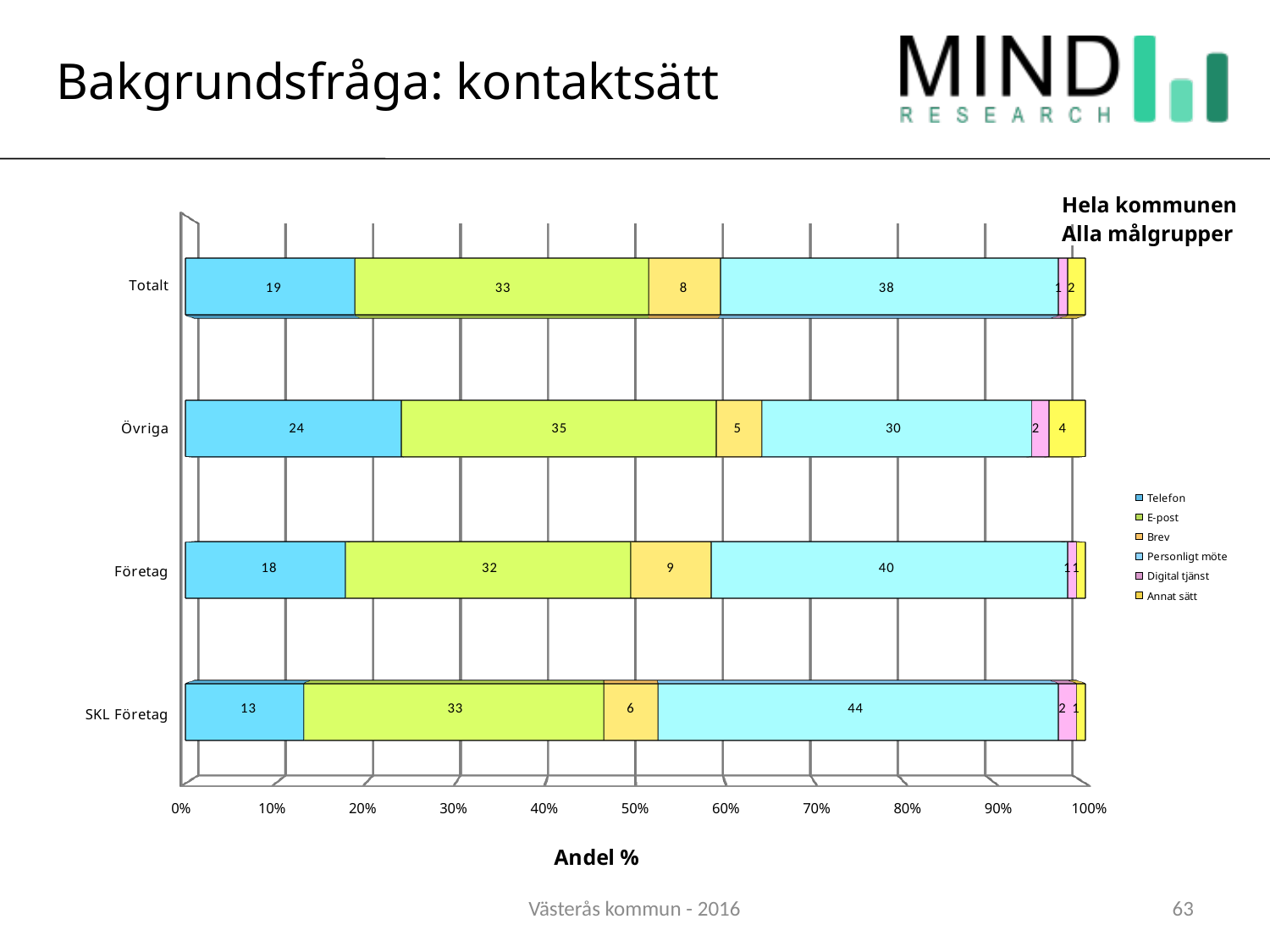
Which category has the highest value for Personligt möte? SKL Företag How many categories are shown on the vertical axis? 4 What is the value for Telefon in the Övriga bar? 24 What is the value for Brev in the Företag bar? 9 What kind of chart is shown on the slide? stacked bar chart What is the title of the horizontal axis? Andel % How many series does the legend list? 6 What is the value for E-post in the Totalt bar? 33 What is the difference between the Telefon values for Övriga and SKL Företag? 11 What is the value for Personligt möte in the SKL Företag bar? 44 Which category has the lowest value for Telefon? SKL Företag Which is larger, the E-post value for Övriga or the E-post value for Företag? Övriga